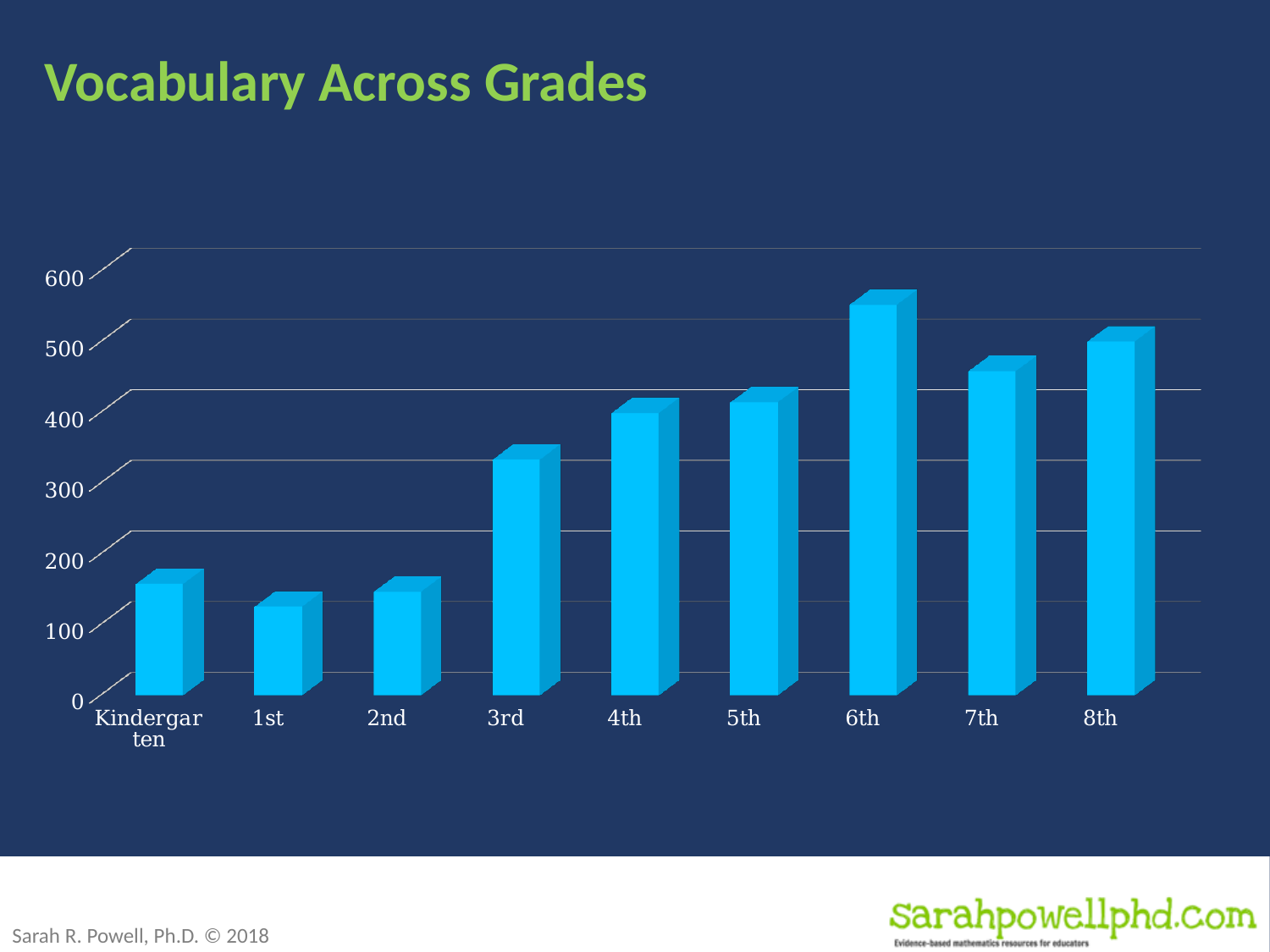
Which is larger, the value for 8th grade or the value for 7th grade? 8th Which grade has the highest value? 6th Is the value for Kindergarten greater or less than 200? less Is the value for 6th grade greater or less than 500? greater Is the value for 5th grade greater or less than 500? less Which grade has the lowest value? 1st What kind of chart is shown on the slide? Bar chart What is the title of the chart? Vocabulary Across Grades How many grade categories are shown on the x axis? 9 Do the values generally rise or fall from Kindergarten to 8th grade? rise